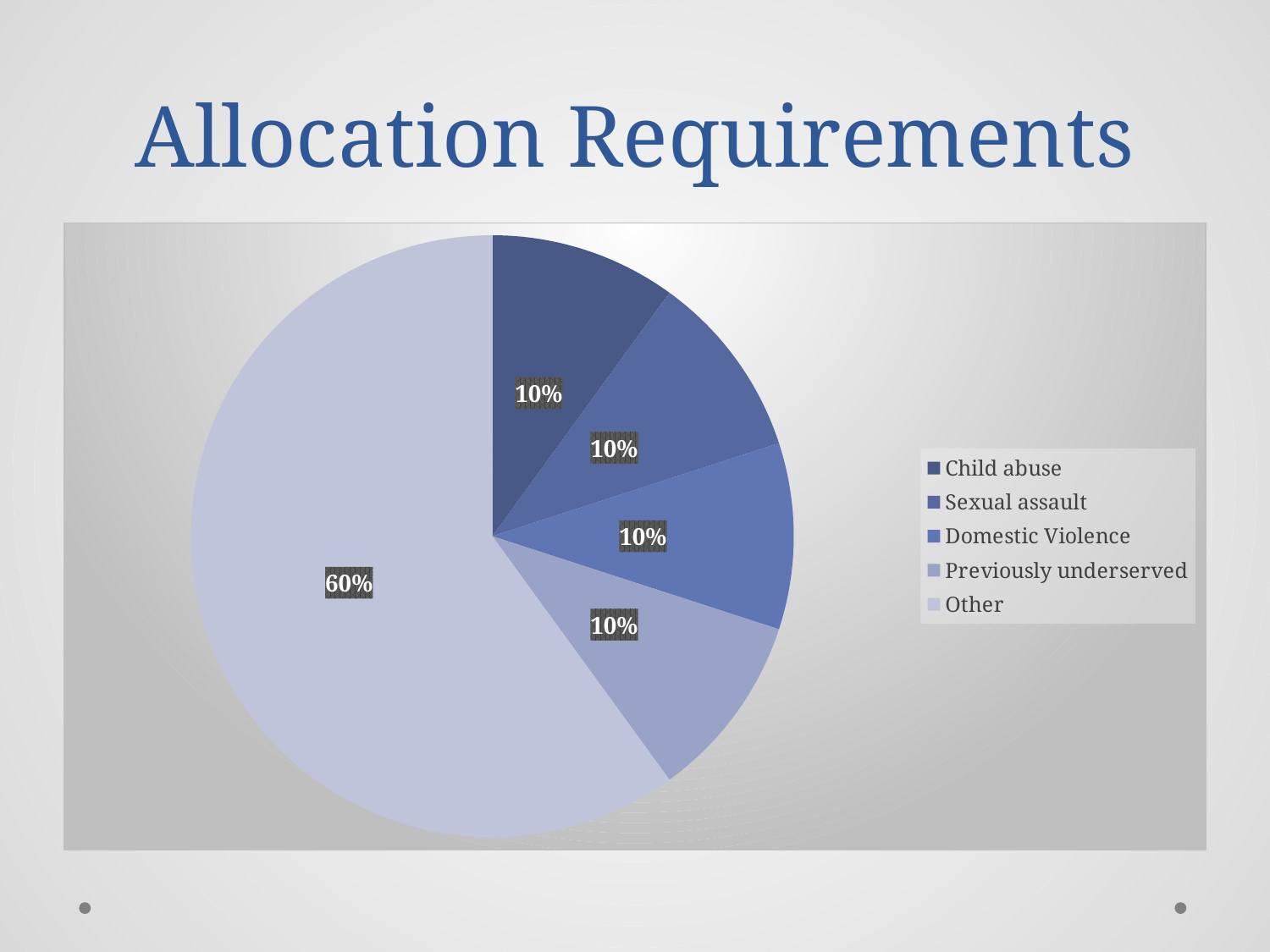
What is the difference between the Other slice and the Sexual assault slice? 50% What is the title of the slide containing the chart? Allocation Requirements What is the value shown for Previously underserved? 10% Is the value for Other greater or less than 50%? greater What kind of chart is shown on the slide? pie chart How many categories does the pie chart show? 5 What is the value shown for Domestic Violence? 10% Which legend entry is listed first? Child abuse Which is larger, the Other slice or the Child abuse slice? Other What is the value shown for Child abuse? 10% What share of the pie does the Other slice represent? 60% Which category has the largest slice of the pie? Other